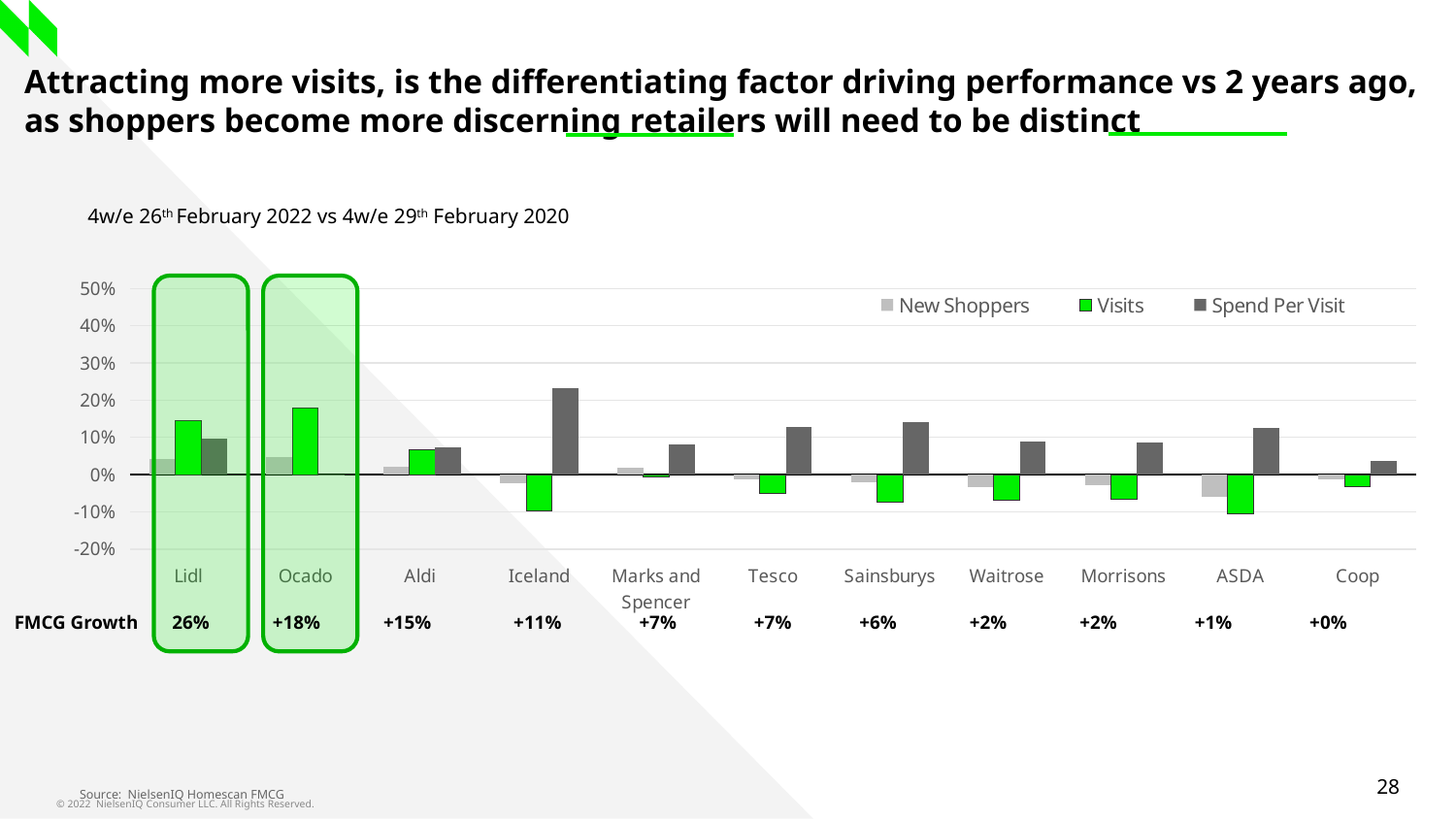
What kind of chart is shown on the slide? bar chart What FMCG Growth value is shown for Lidl below the chart? 26% Which retailer has the highest Spend Per Visit value in the chart? Iceland How many series does the chart legend list? 3 What FMCG Growth value is shown for Coop below the chart? +0% Is the Visits value for Lidl greater or less than 10%? greater How many retailers are shown along the x axis of the chart? 11 Is the Spend Per Visit value for Iceland greater or less than 20%? greater Which retailer has the highest Visits value in the chart? Ocado Which is larger, the Visits value for Ocado or the Visits value for Aldi? Ocado Is the Visits value for ASDA greater or less than 0%? less What period comparison is stated above the chart? 4w/e 26th February 2022 vs 4w/e 29th February 2020